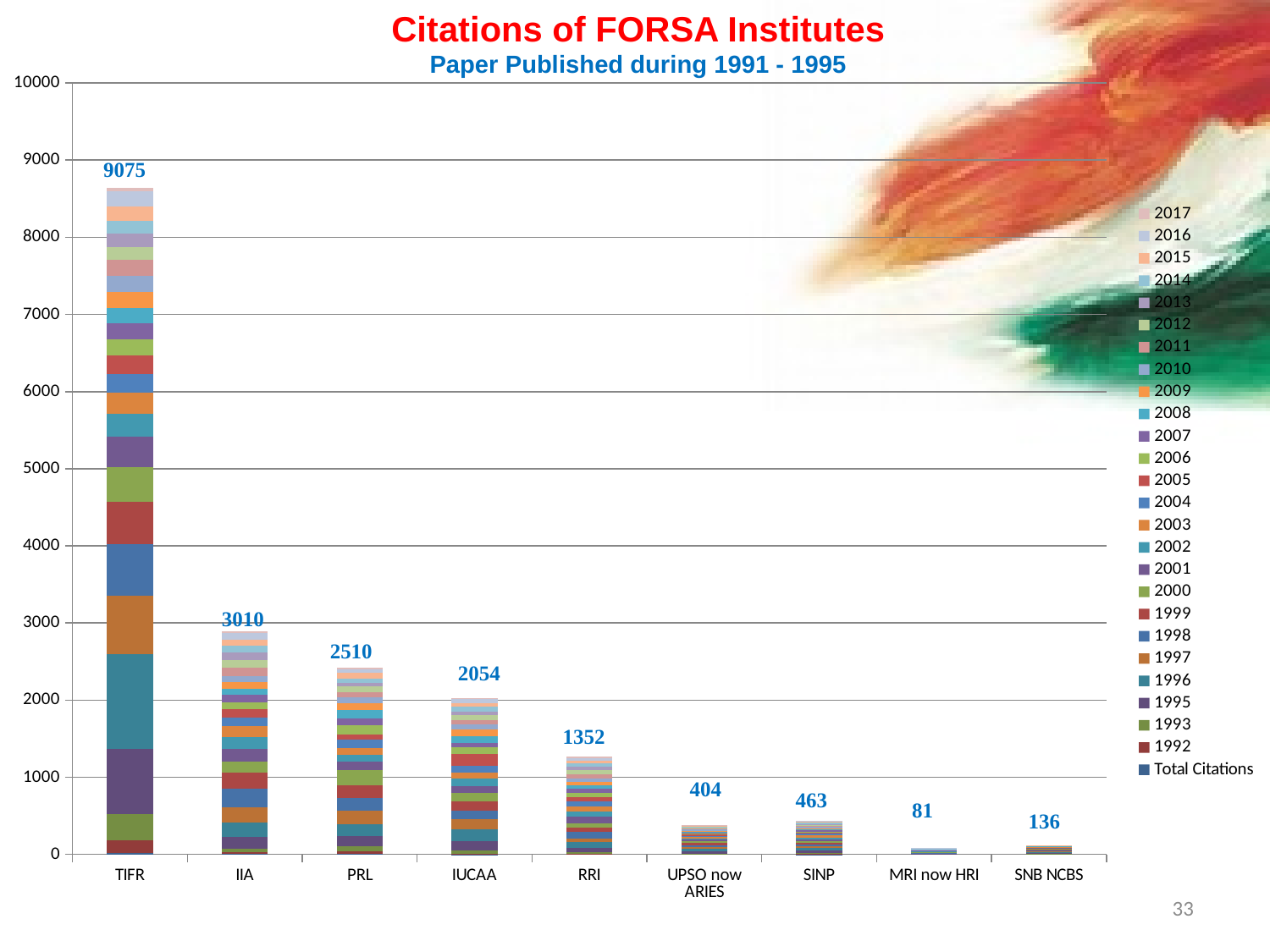
How many institutes are shown on the x axis? 9 Which has more total citations, PRL or IUCAA? PRL What is the total citations value labelled for TIFR? 9075 What is the difference between the total citations of SINP and UPSO now ARIES? 59 What is the difference between the total citations of TIFR and IIA? 6065 Which institute has the highest total citations? TIFR Which institute has the lowest total citations? MRI now HRI What type of chart is shown on the slide? stacked bar chart How many entries does the legend list? 26 What is the total citations value labelled for MRI now HRI? 81 What is the subtitle of the chart? Paper Published during 1991 - 1995 What is the total citations value labelled for IUCAA? 2054